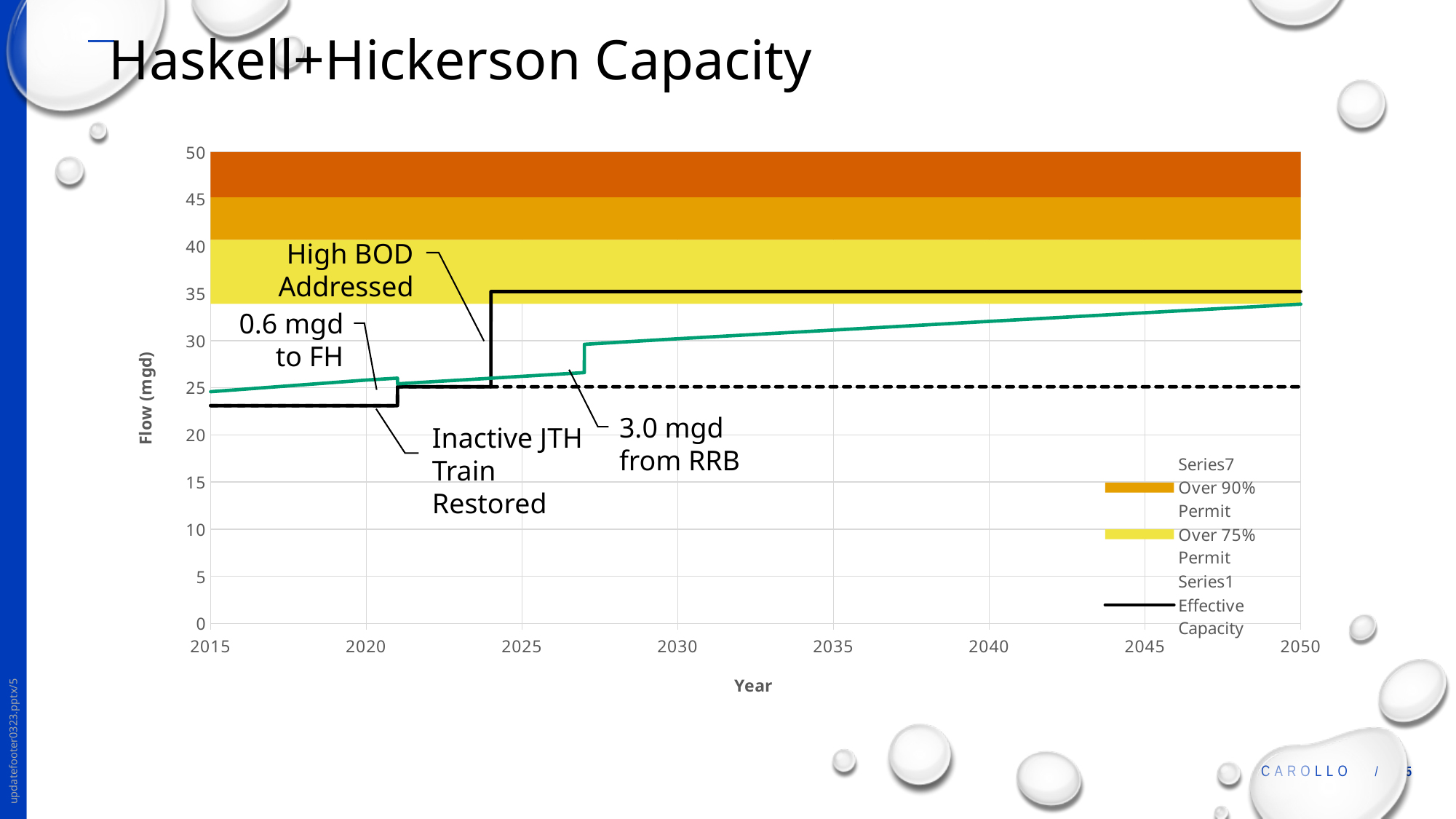
Is the Effective Capacity value in 2015 greater or less than 25? less Which is larger in 2015, the green flow line or the Effective Capacity line? green flow line How many entries does the chart legend list? 5 Is the Effective Capacity value in 2030 greater or less than 30? greater Which annotation is attached to the step in the Effective Capacity line around 2024? High BOD Addressed Does the green flow line rise or fall from 2015 to 2050? rise What kind of chart is shown on the slide? combination area and line chart What is the label of the y axis? Flow (mgd) What is the title of the chart? Haskell+Hickerson Capacity Which is larger in 2040, the Effective Capacity line or the green flow line? Effective Capacity Is the green flow line value in 2050 greater or less than 35? less